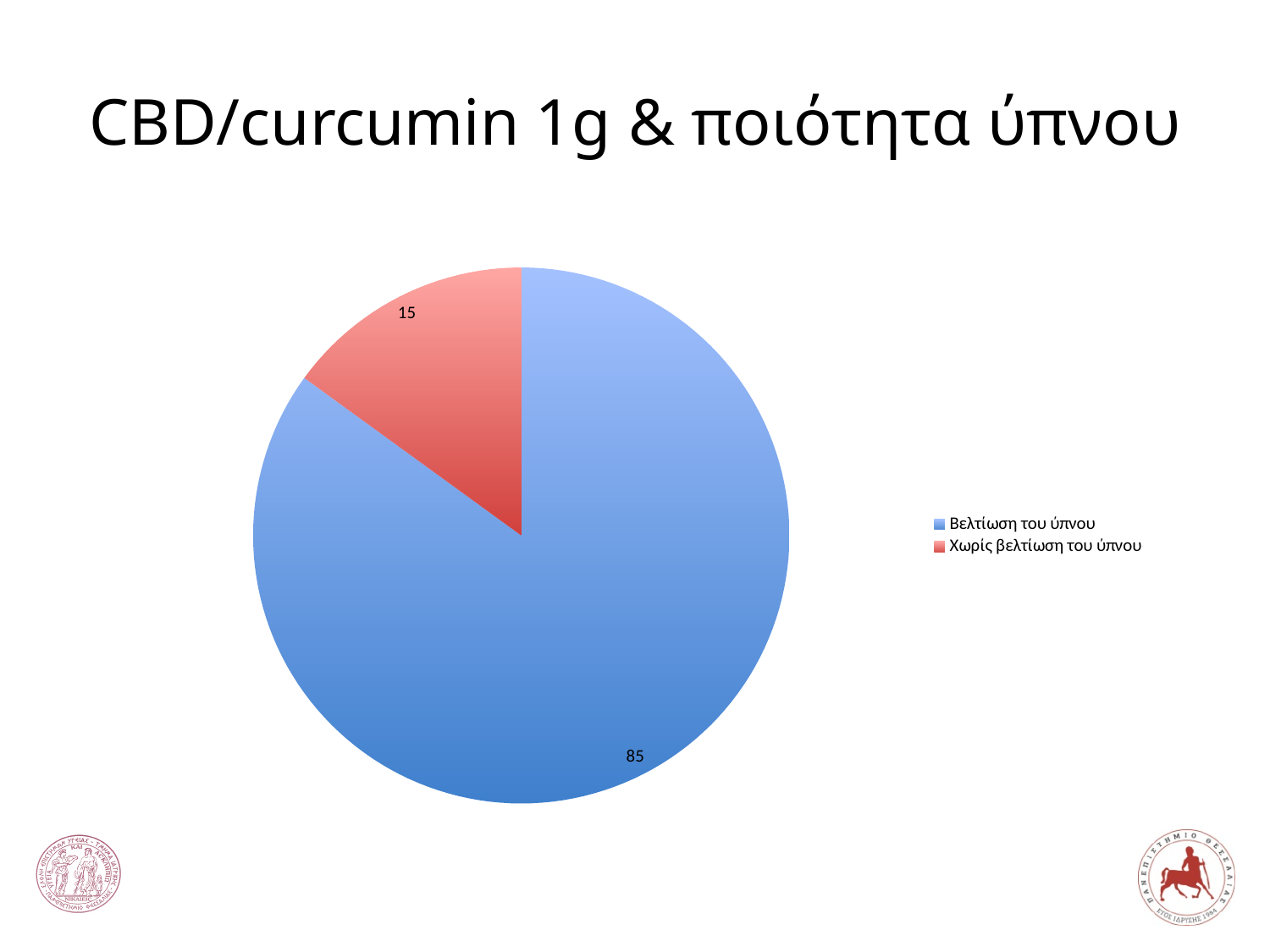
Which category has the largest slice? Βελτίωση του ύπνου What share of the pie does Χωρίς βελτίωση του ύπνου represent? 15% What is the title of the slide containing the chart? CBD/curcumin 1g & ποιότητα ύπνου Which is larger, the value for Βελτίωση του ύπνου or the value for Χωρίς βελτίωση του ύπνου? Βελτίωση του ύπνου What kind of chart is shown on the slide? pie chart What colour is the slice for Χωρίς βελτίωση του ύπνου? red How many entries does the legend list? 2 What is the value for Βελτίωση του ύπνου? 85 How many slices does the pie chart have? 2 What is the difference between the values for Βελτίωση του ύπνου and Χωρίς βελτίωση του ύπνου? 70 What is the value for Χωρίς βελτίωση του ύπνου? 15 Which category has the smallest slice? Χωρίς βελτίωση του ύπνου